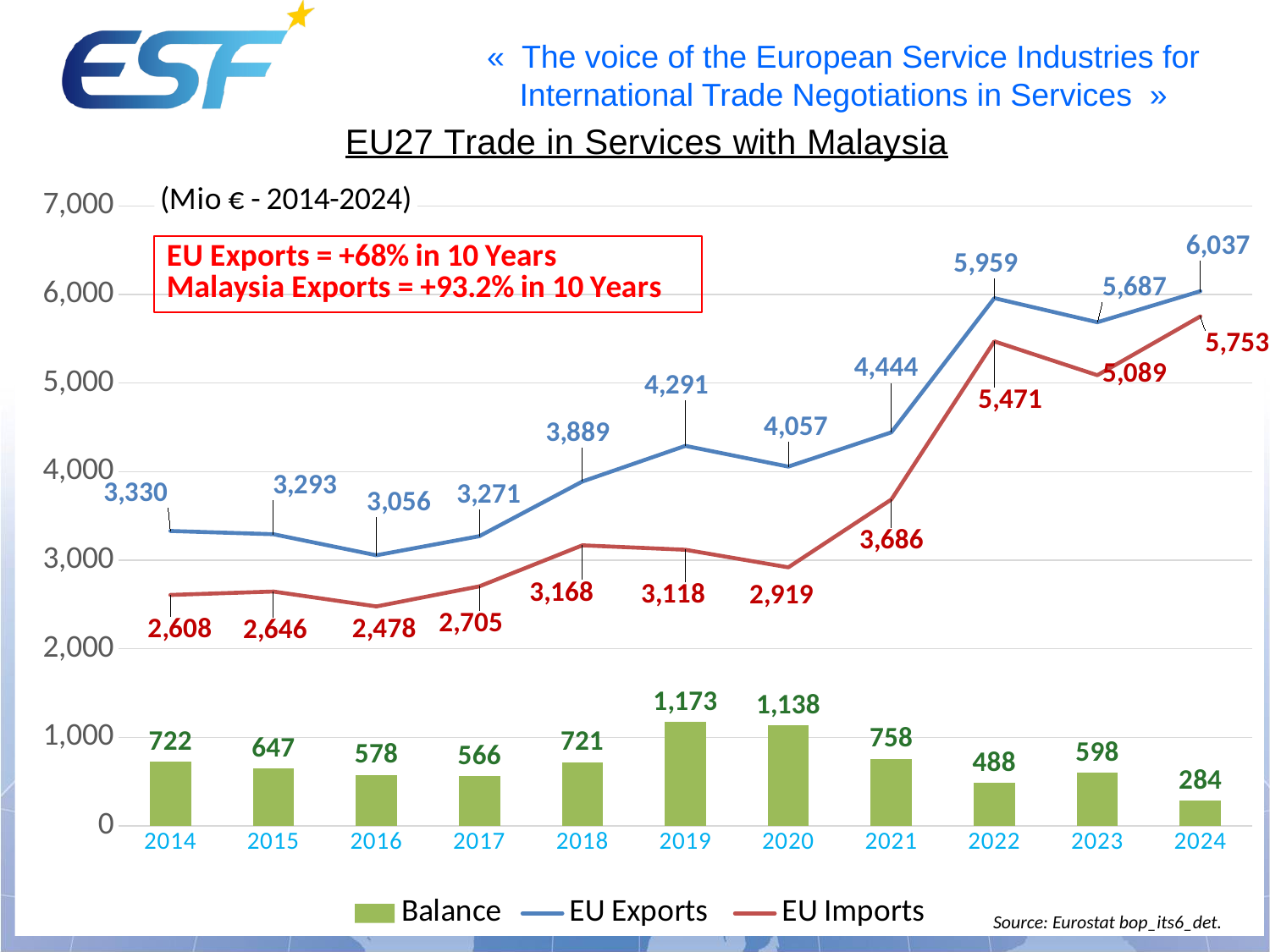
Is the value of EU Imports in 2021 greater or less than 4,000? less What is the title of the chart? EU27 Trade in Services with Malaysia What is the Balance value for 2019? 1,173 Which is larger in 2020: EU Exports or EU Imports? EU Exports What is the value of EU Exports in 2024? 6,037 How many years are shown on the x axis? 11 What is the difference between EU Exports and EU Imports in 2022? 488 In which year are EU Exports highest? 2024 How many series does the legend list? 3 In which year is the Balance lowest? 2024 Do EU Imports rise or fall from 2021 to 2022? rise What is the value of EU Imports in 2016? 2,478